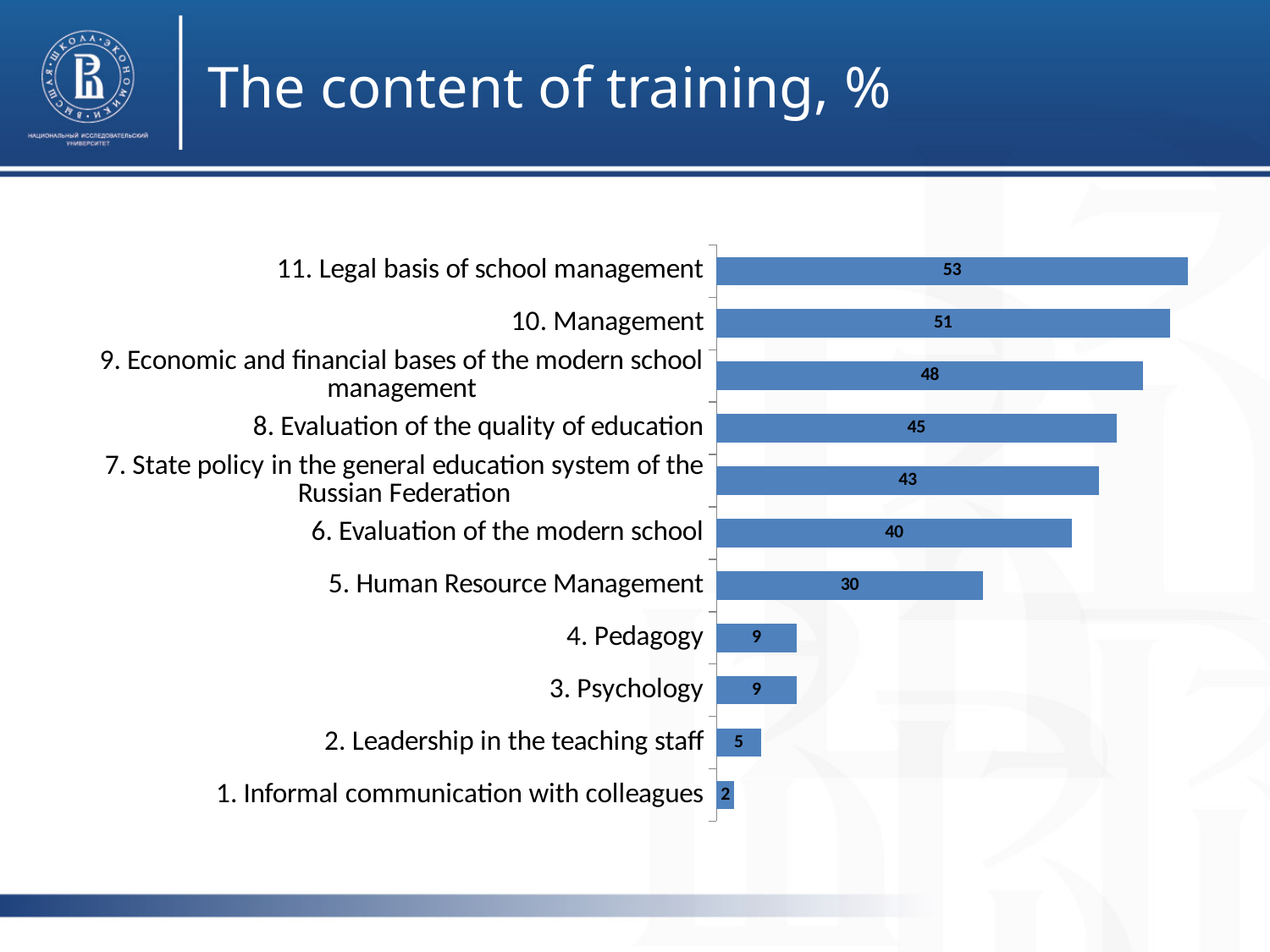
How many categories are shown in the chart? 11 What is the value for "5. Human Resource Management"? 30 Which is larger, the value for "9. Economic and financial bases of the modern school management" or the value for "5. Human Resource Management"? 9. Economic and financial bases of the modern school management Which category has the lowest value? 1. Informal communication with colleagues What is the value for "7. State policy in the general education system of the Russian Federation"? 43 Do the values for "3. Psychology" and "4. Pedagogy" differ? No, both are 9 What is the difference between the values for "10. Management" and "6. Evaluation of the modern school"? 11 What is the title of the slide containing the chart? The content of training, % What is the difference between the values for "8. Evaluation of the quality of education" and "2. Leadership in the teaching staff"? 40 What kind of chart is shown on the slide? Bar chart What is the value for "11. Legal basis of school management"? 53 Which category has the highest value? 11. Legal basis of school management